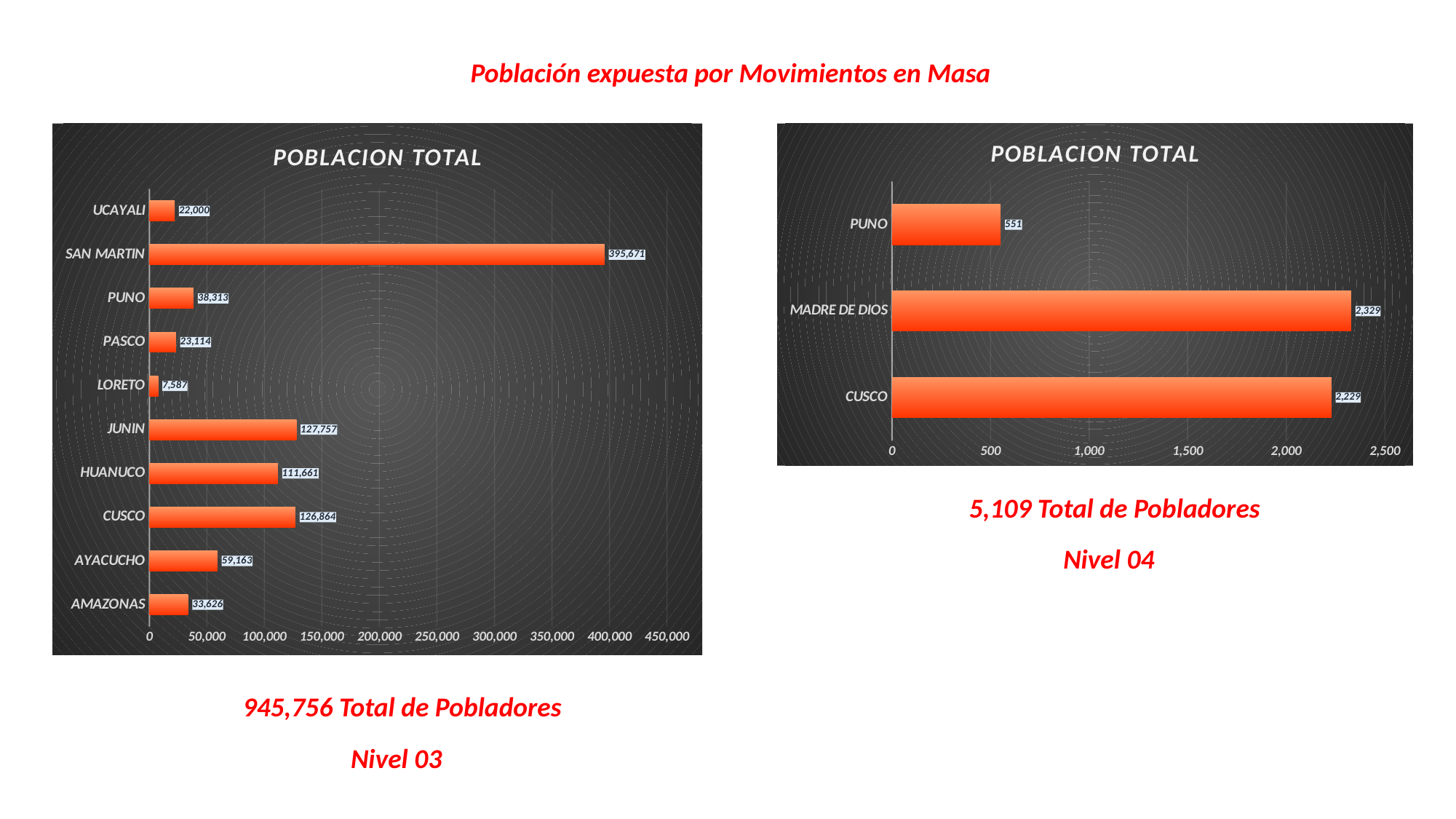
In the left chart (Nivel 03), what is the value for JUNIN? 127,757 In the left chart (Nivel 03), which is larger, the value for PUNO or the value for AMAZONAS? PUNO In the left chart (Nivel 03), what is the difference between the values for CUSCO and HUANUCO? 15,203 In the right chart (Nivel 04), what is the difference between the values for MADRE DE DIOS and CUSCO? 100 What kind of chart is the right chart (Nivel 04)? Bar chart In the right chart (Nivel 04), what is the value for PUNO? 551 How many categories are shown in the right chart (Nivel 04)? 3 How many categories are shown in the left chart (Nivel 03)? 10 In the left chart (Nivel 03), which category has the lowest value? LORETO In the left chart (Nivel 03), what is the value for SAN MARTIN? 395,671 In the left chart (Nivel 03), which category has the highest value? SAN MARTIN In the right chart (Nivel 04), which category has the highest value? MADRE DE DIOS